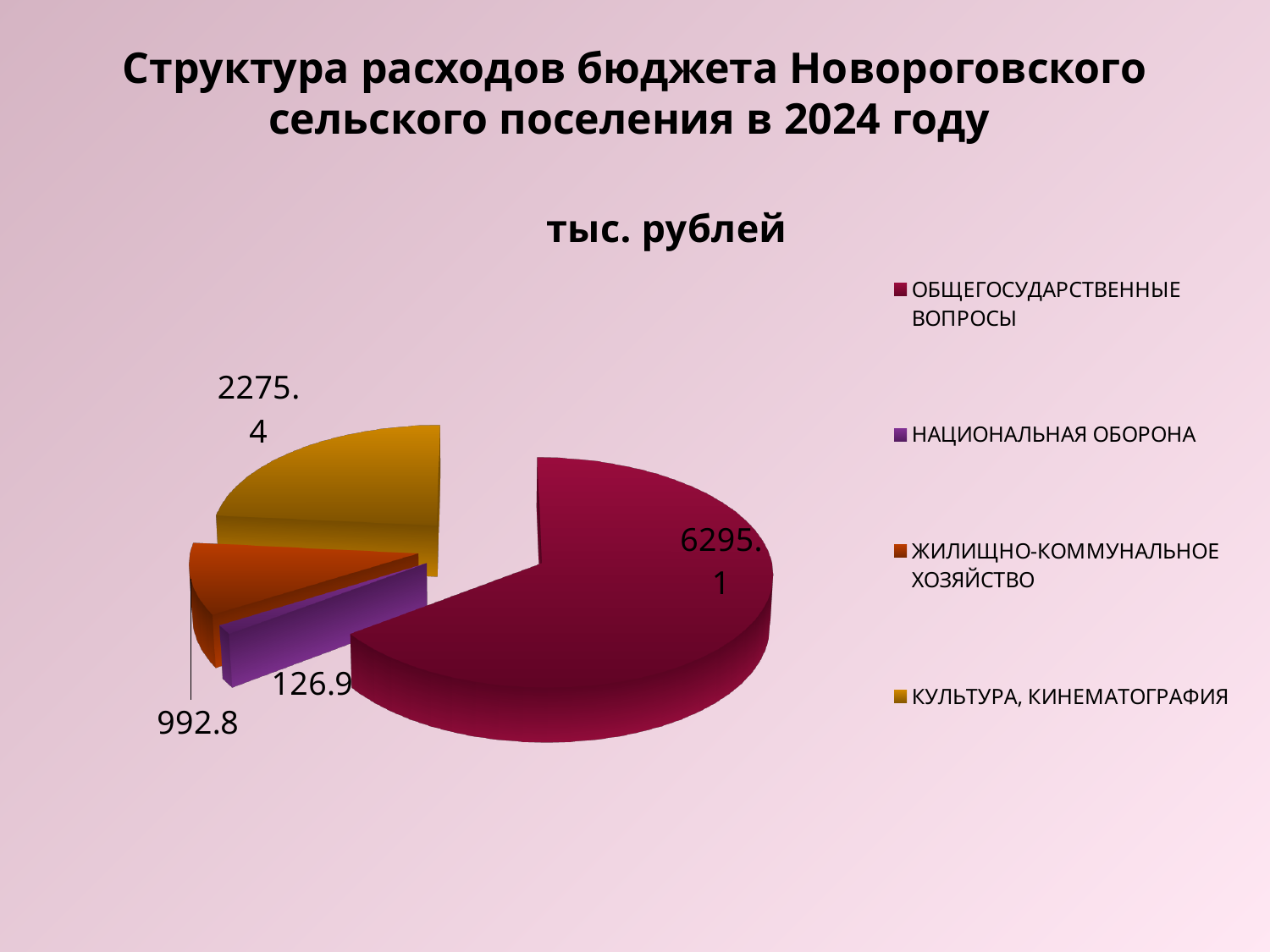
Which category has the largest slice of the pie? ОБЩЕГОСУДАРСТВЕННЫЕ ВОПРОСЫ What is the value for ОБЩЕГОСУДАРСТВЕННЫЕ ВОПРОСЫ? 6295.1 What is the value for ЖИЛИЩНО-КОММУНАЛЬНОЕ ХОЗЯЙСТВО? 992.8 How many categories does the pie chart show? 4 What kind of chart is shown on the slide? pie chart Which is larger: the value for ЖИЛИЩНО-КОММУНАЛЬНОЕ ХОЗЯЙСТВО or the value for НАЦИОНАЛЬНАЯ ОБОРОНА? ЖИЛИЩНО-КОММУНАЛЬНОЕ ХОЗЯЙСТВО What colour is the slice for КУЛЬТУРА, КИНЕМАТОГРАФИЯ? gold What is the value for КУЛЬТУРА, КИНЕМАТОГРАФИЯ? 2275.4 What is the value for НАЦИОНАЛЬНАЯ ОБОРОНА? 126.9 What is the difference between the values for ОБЩЕГОСУДАРСТВЕННЫЕ ВОПРОСЫ and КУЛЬТУРА, КИНЕМАТОГРАФИЯ? 4019.7 What is the title of the chart? тыс. рублей Which category has the smallest slice of the pie? НАЦИОНАЛЬНАЯ ОБОРОНА